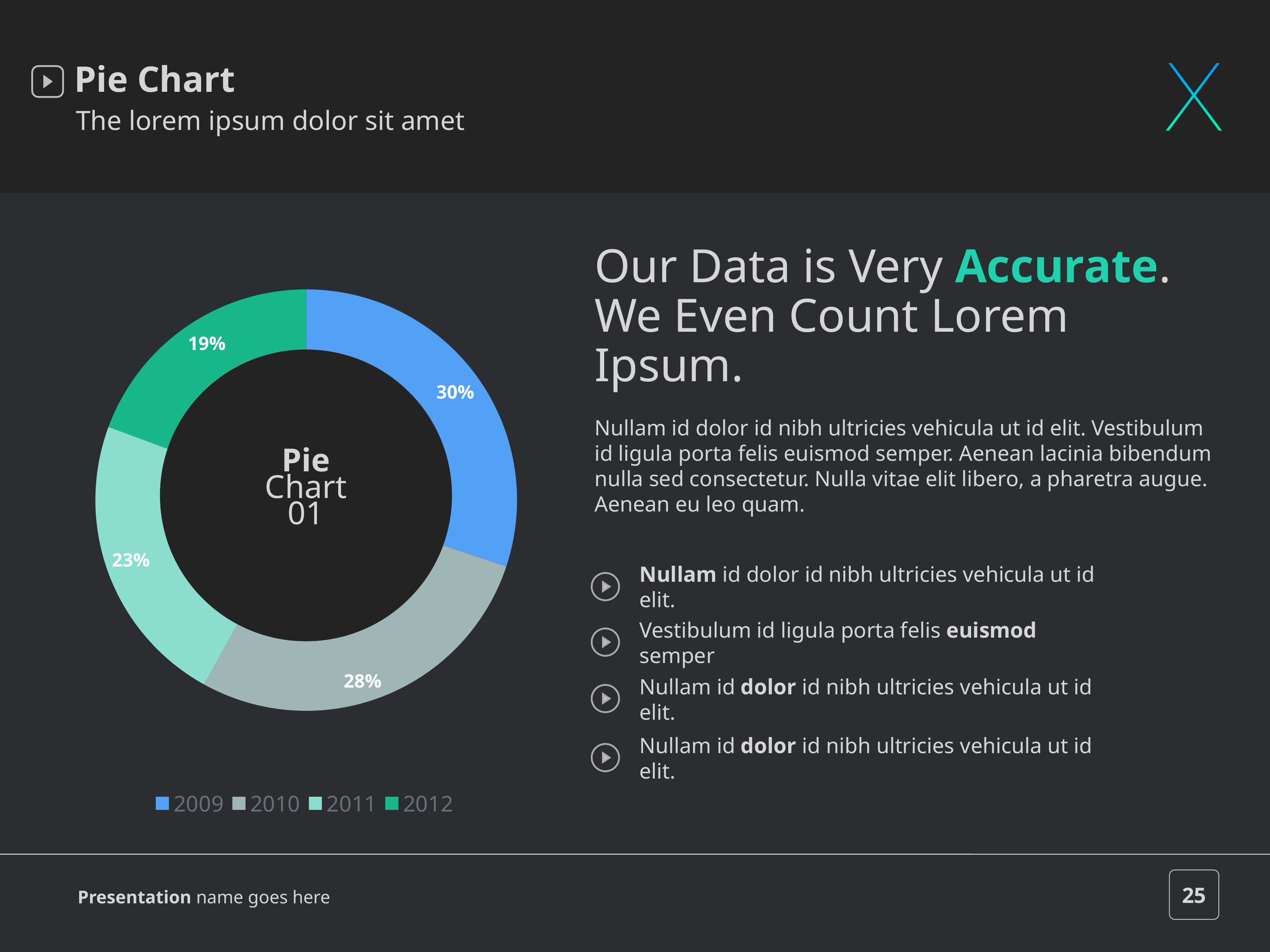
What text is shown in the centre of the doughnut chart? Pie Chart 01 What is the value for 2009? 30% What is the value for 2010? 28% Which year has the smallest share? 2012 Which year has the largest share? 2009 How many categories does the pie chart have? 4 Which is larger, the share for 2010 or the share for 2011? 2010 What is the value for 2012? 19% How many entries does the legend list? 4 What kind of chart is shown on the slide? Pie chart (doughnut) What is the value for 2011? 23% What is the difference between the shares for 2009 and 2012? 11%